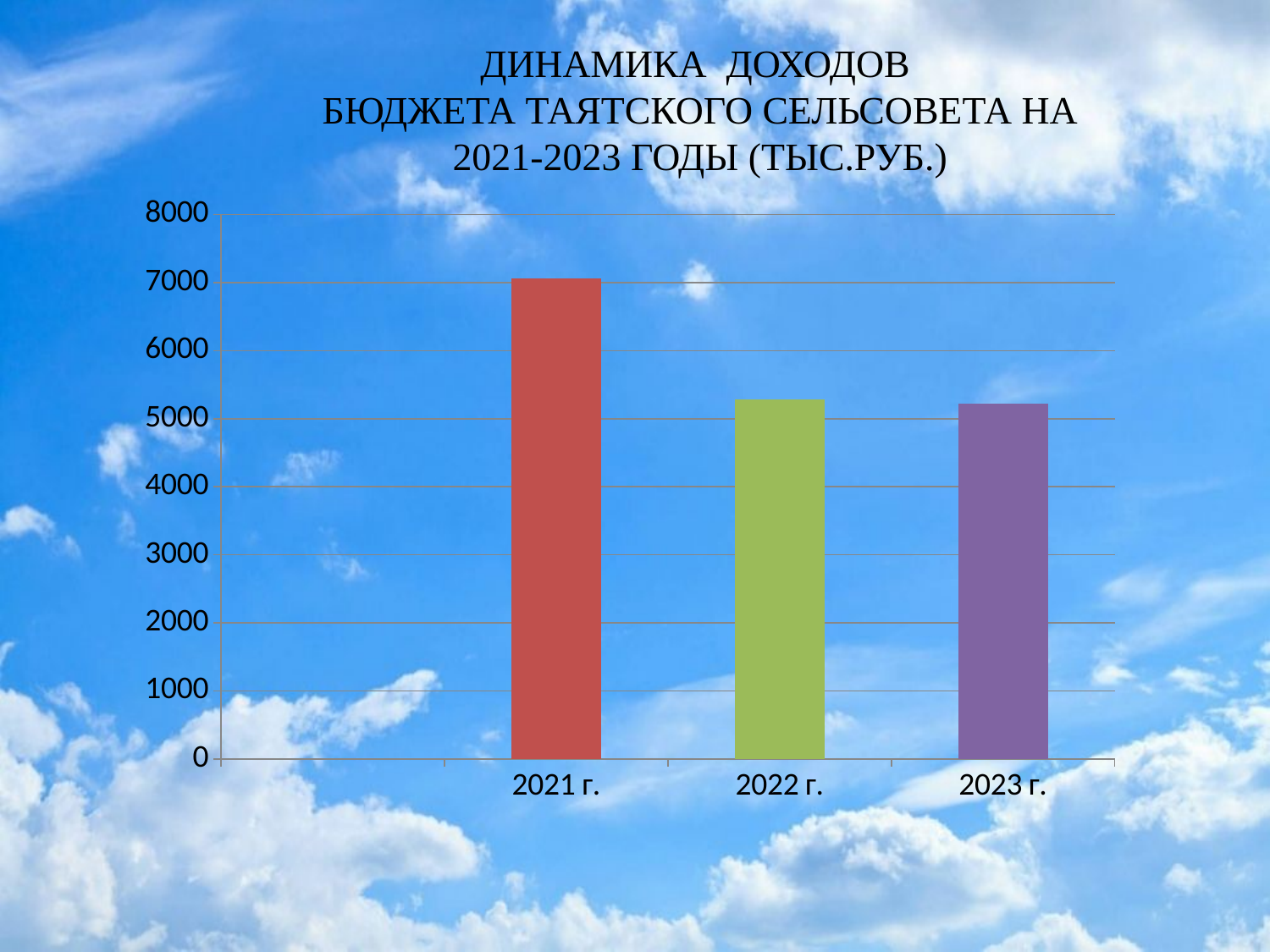
What colour is the bar for 2021 г.? red Which is larger, the value for 2021 г. or the value for 2022 г.? 2021 г. How many years (categories) are plotted on the chart? 3 Is the value for 2023 г. greater or less than 6000? less In what units are the values on the chart given, according to the title? тыс.руб. What kind of chart is shown on the slide? bar chart Is the value for 2022 г. greater or less than 6000? less Do the values rise or fall from 2021 г. to 2023 г.? fall Is the value for 2021 г. greater or less than 6000? greater Which year has the highest budget income? 2021 г.